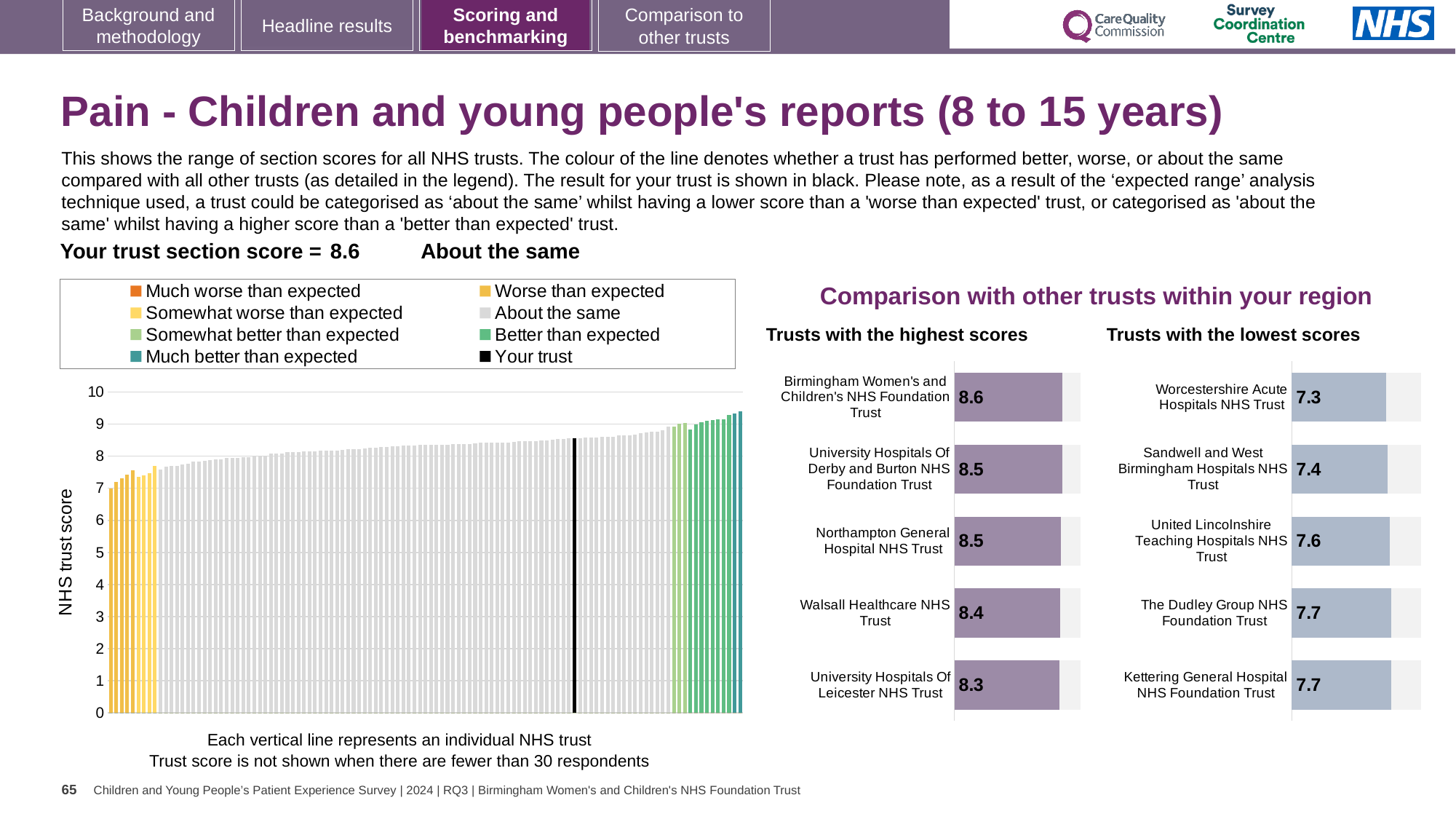
In the 'Trusts with the lowest scores' chart, what is the score for Worcestershire Acute Hospitals NHS Trust? 7.3 How many trusts are listed in the 'Trusts with the highest scores' chart? 5 In the 'Trusts with the highest scores' chart, what is the score for Walsall Healthcare NHS Trust? 8.4 In the 'Trusts with the lowest scores' chart, which has the higher score: Sandwell and West Birmingham Hospitals NHS Trust or United Lincolnshire Teaching Hospitals NHS Trust? United Lincolnshire Teaching Hospitals NHS Trust In the 'Trusts with the highest scores' chart, what is the difference between the scores of Birmingham Women's and Children's NHS Foundation Trust and University Hospitals Of Leicester NHS Trust? 0.3 In the 'Trusts with the highest scores' chart, which trust has the lowest score? University Hospitals Of Leicester NHS Trust What is the y-axis label of the large chart on the left? NHS trust score In the 'Trusts with the lowest scores' chart, which trust has the lowest score? Worcestershire Acute Hospitals NHS Trust In the large chart on the left, is the value for the black 'Your trust' bar greater or less than 8? greater In the 'Trusts with the highest scores' chart, what is the score for Birmingham Women's and Children's NHS Foundation Trust? 8.6 In the 'Trusts with the lowest scores' chart, what is the difference between the scores of Kettering General Hospital NHS Foundation Trust and Worcestershire Acute Hospitals NHS Trust? 0.4 In the 'Trusts with the lowest scores' chart, what is the score for United Lincolnshire Teaching Hospitals NHS Trust? 7.6